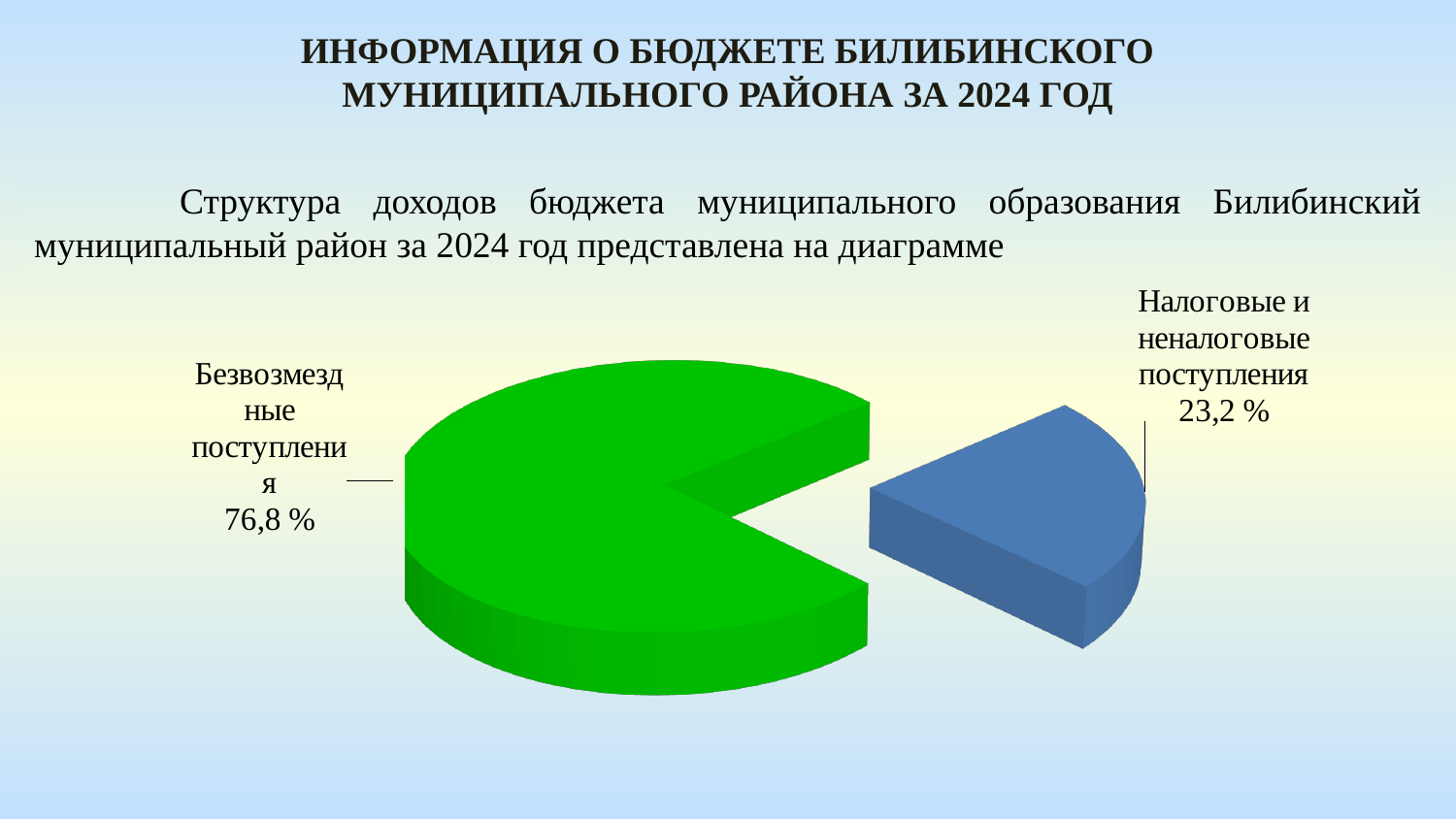
How many slices does the pie chart have? 2 Is the share of "Налоговые и неналоговые поступления" greater or less than 50%? less What colour is the slice for "Безвозмездные поступления"? Green What colour is the slice for "Налоговые и неналоговые поступления"? Blue What share of the pie does "Налоговые и неналоговые поступления" represent? 23,2 % Which category has the smallest slice of the pie? Налоговые и неналоговые поступления Which category has the largest slice of the pie? Безвозмездные поступления What share of the pie does "Безвозмездные поступления" represent? 76,8 % Which is larger: the share of "Безвозмездные поступления" or the share of "Налоговые и неналоговые поступления"? Безвозмездные поступления What kind of chart is shown on the slide? Pie chart What is the difference in percentage points between "Безвозмездные поступления" and "Налоговые и неналоговые поступления"? 53,6